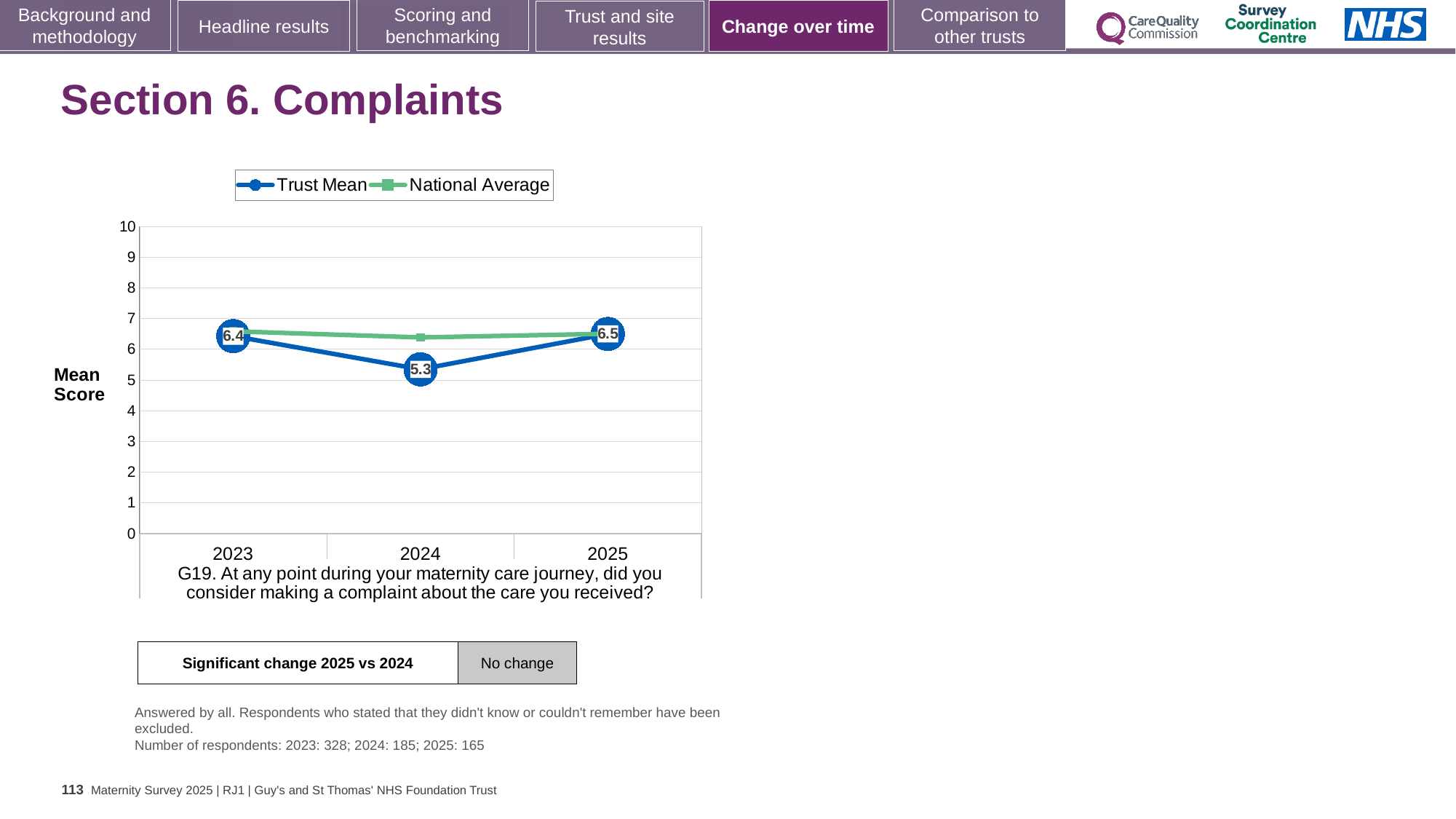
Is the National Average value for 2024 greater or less than 5? greater Which is larger, the Trust Mean for 2023 or for 2024? 2023 What is the difference between the Trust Mean in 2025 and in 2024? 1.2 What is the Trust Mean value for 2023? 6.4 Does the Trust Mean rise or fall from 2023 to 2024? fall In which year is the Trust Mean lowest? 2024 What kind of chart is shown on the slide? line chart How many series does the legend list? 2 In which year is the Trust Mean highest? 2025 How many years are plotted on the x axis? 3 What is the Trust Mean value for 2024? 5.3 What is the Trust Mean value for 2025? 6.5